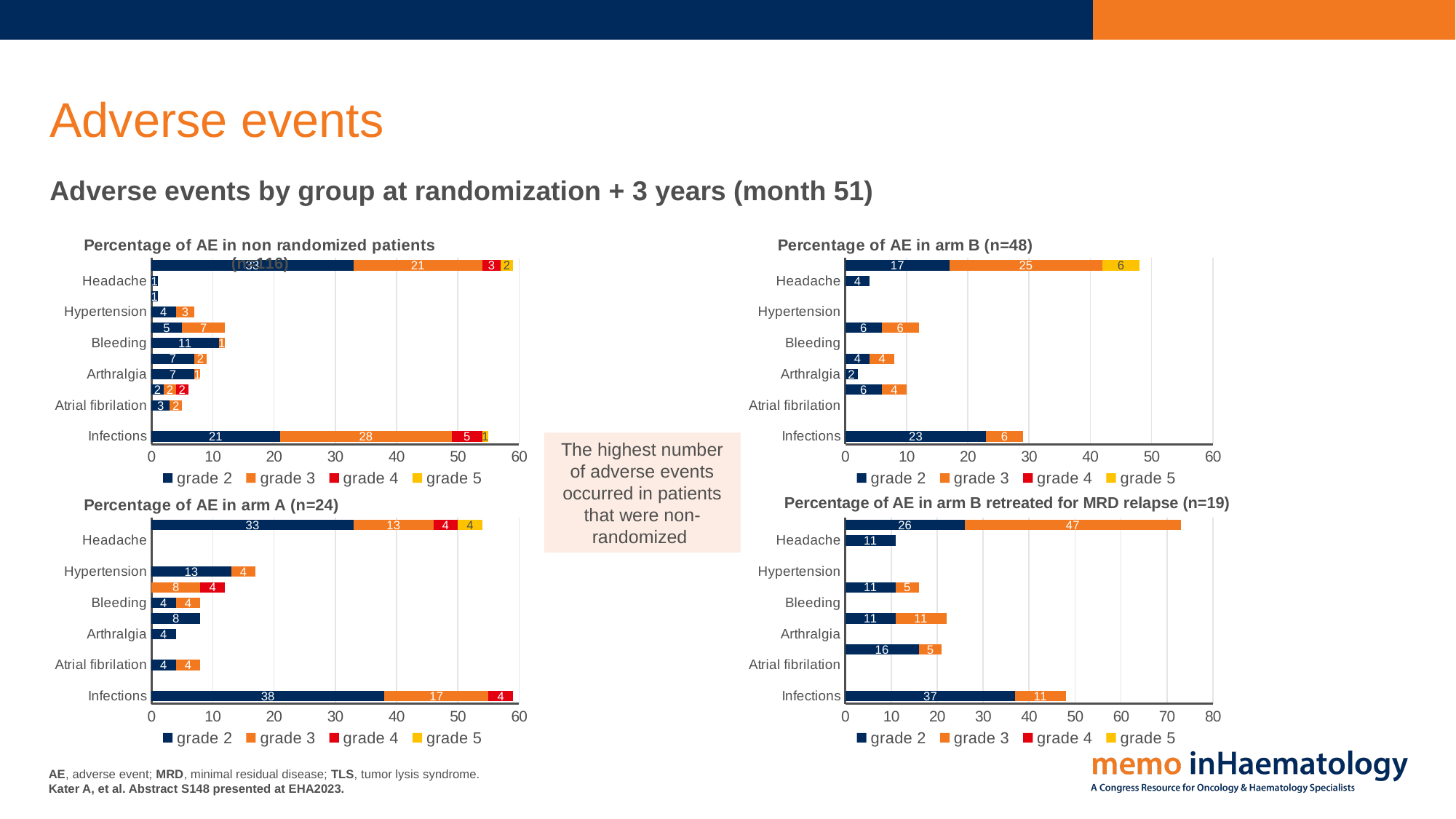
How many series does the legend of the 'Percentage of AE in arm A (n=24)' chart list? 4 In the 'Percentage of AE in arm B retreated for MRD relapse (n=19)' chart, is the grade 2 value for Infections greater or less than 30? greater In the 'Percentage of AE in arm A (n=24)' chart, what is the grade 4 value for Infections? 4 In the 'Percentage of AE in arm A (n=24)' chart, what is the grade 2 value for Infections? 38 In the 'Percentage of AE in arm B (n=48)' chart, what is the total of the stacked Infections bar? 29 What is the maximum value shown on the x axis of the 'Percentage of AE in arm B retreated for MRD relapse (n=19)' chart? 80 Which chart shows a larger grade 2 value for Infections: 'Percentage of AE in arm A (n=24)' or 'Percentage of AE in arm B (n=48)'? Percentage of AE in arm A (n=24) In the 'Percentage of AE in arm A (n=24)' chart, what is the difference between the grade 2 and grade 3 values for Infections? 21 In the 'Percentage of AE in non randomized patients' chart, what is the grade 3 value for Infections? 28 In the 'Percentage of AE in arm B (n=48)' chart, what is the grade 2 value for Headache? 4 In the 'Percentage of AE in arm B retreated for MRD relapse (n=19)' chart, what is the total of the stacked Infections bar? 48 What kind of chart is the 'Percentage of AE in arm B (n=48)' chart? Stacked horizontal bar chart